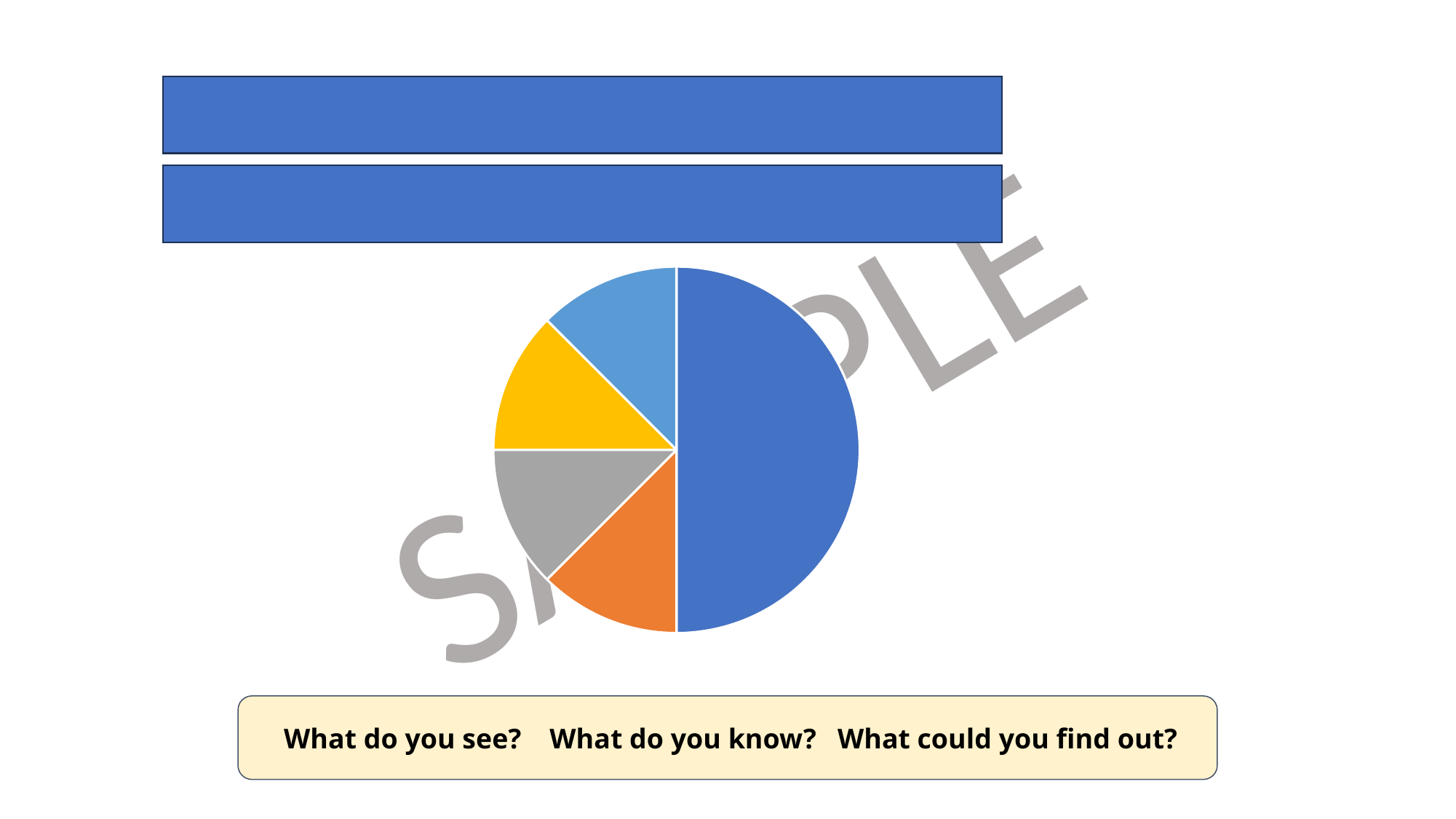
How many slices does the pie chart have? 5 Does the pie chart show a legend? No Which is larger in the pie chart, the dark blue slice or the orange slice? dark blue Which colour slice is the largest in the pie chart? dark blue What kind of chart is shown on the slide? pie chart Does the pie chart display data labels on its slices? No Which is larger in the pie chart, the dark blue slice or the yellow slice? dark blue